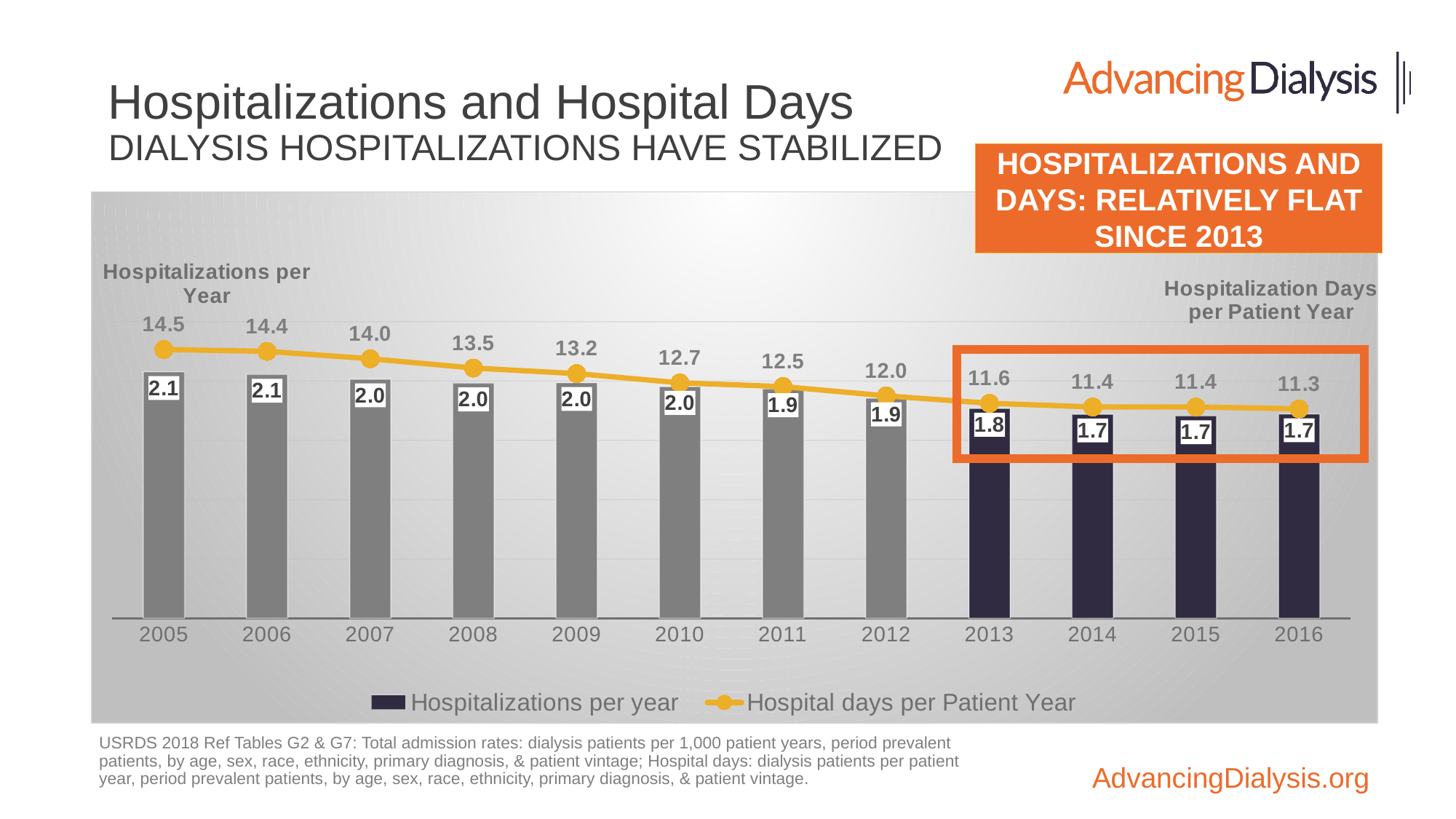
What kind of chart is used to show Hospitalizations per year? bar chart How many years are shown on the x axis? 12 Does Hospital days per Patient Year rise or fall from 2005 to 2016? fall How many series does the legend list? 2 What is the value of Hospital days per Patient Year in 2005? 14.5 What is the value of Hospitalizations per year in 2013? 1.8 Which year has the lowest Hospital days per Patient Year? 2016 Which year has the highest Hospital days per Patient Year? 2005 What is the value of Hospital days per Patient Year in 2012? 12.0 Which is larger, Hospital days per Patient Year in 2008 or in 2011? 2008 What is the value of Hospitalizations per year in 2016? 1.7 What is the difference in Hospital days per Patient Year between 2005 and 2016? 3.2